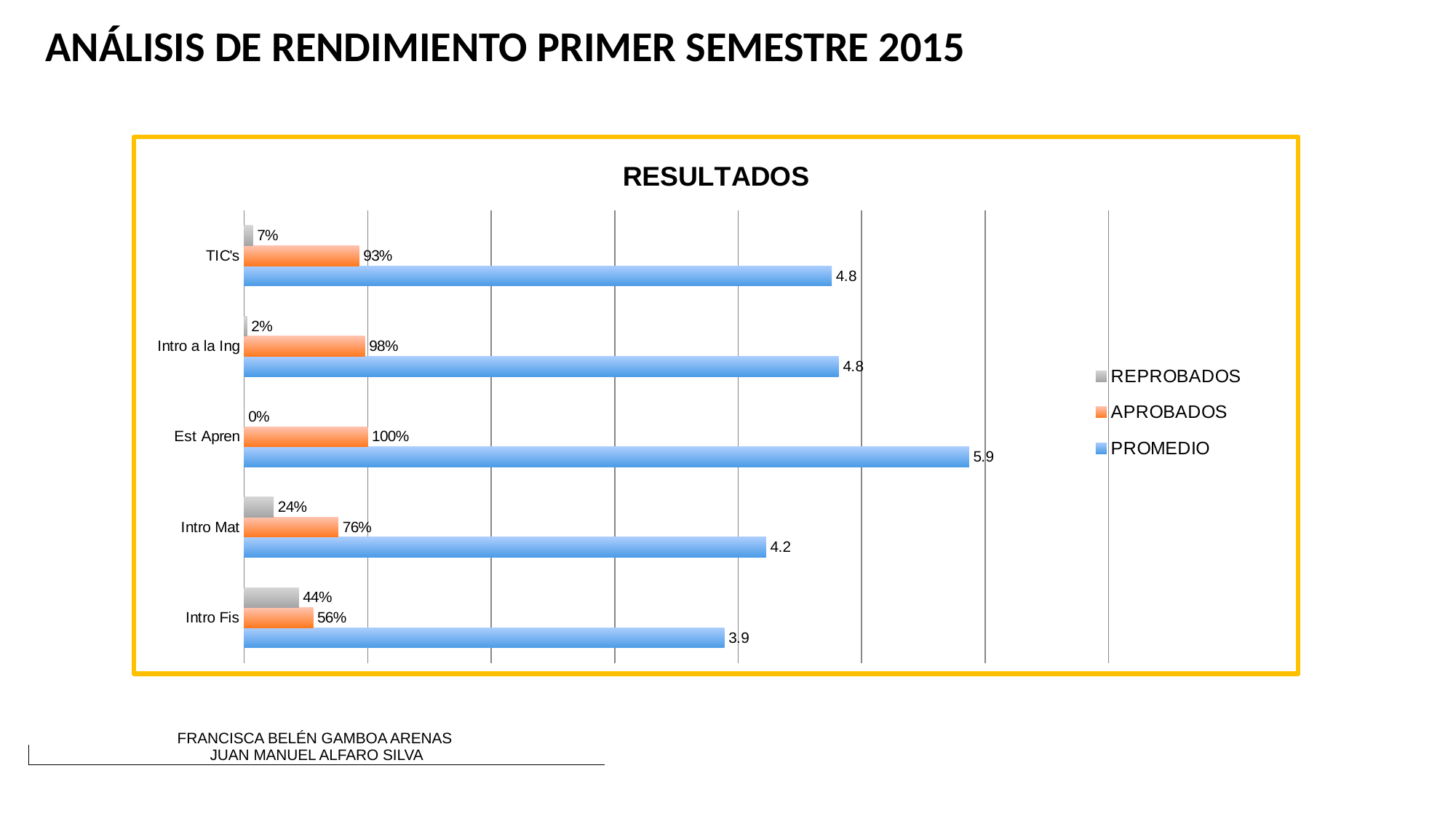
What is the difference between the APROBADOS values for Intro a la Ing and Intro Mat? 22% Which is larger, the REPROBADOS value for Intro Mat or for TIC's? Intro Mat Which category has the lowest APROBADOS value? Intro Fis What is the APROBADOS value for TIC's? 93% How many categories are shown on the chart? 5 What is the title of the chart? RESULTADOS What kind of chart is shown? bar chart How many series does the legend list? 3 What is the REPROBADOS value for Intro Fis? 44% Which category has the highest PROMEDIO value? Est Apren What is the APROBADOS value for Intro Mat? 76% What is the PROMEDIO value for Est Apren? 5.9